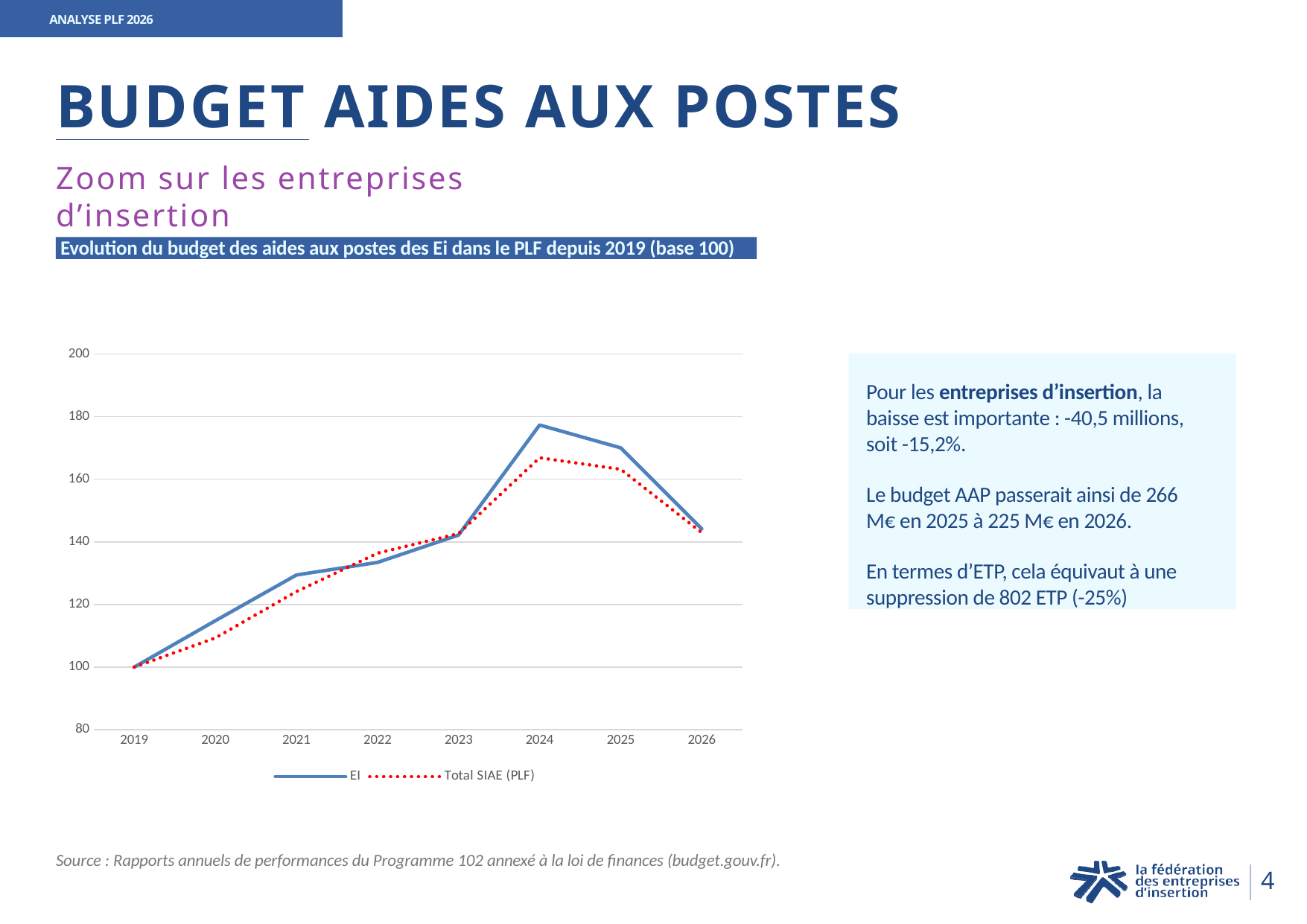
Is the value for EI in 2024 greater or less than 160? greater Is the value for Total SIAE (PLF) in 2020 greater or less than 120? less In which year does the Total SIAE (PLF) series reach its highest value? 2024 In which year does the EI series reach its highest value? 2024 How many years are plotted along the x axis of the chart? 8 How many series does the chart legend list? 2 What is the value of the EI series in 2019? 100 Is the value for EI in 2026 greater or less than 140? greater In which year is the EI series at its lowest value? 2019 In 2024, which series has the larger value, EI or Total SIAE (PLF)? EI Do the values of the EI series rise or fall between 2024 and 2026? fall What kind of chart is shown on the slide? line chart